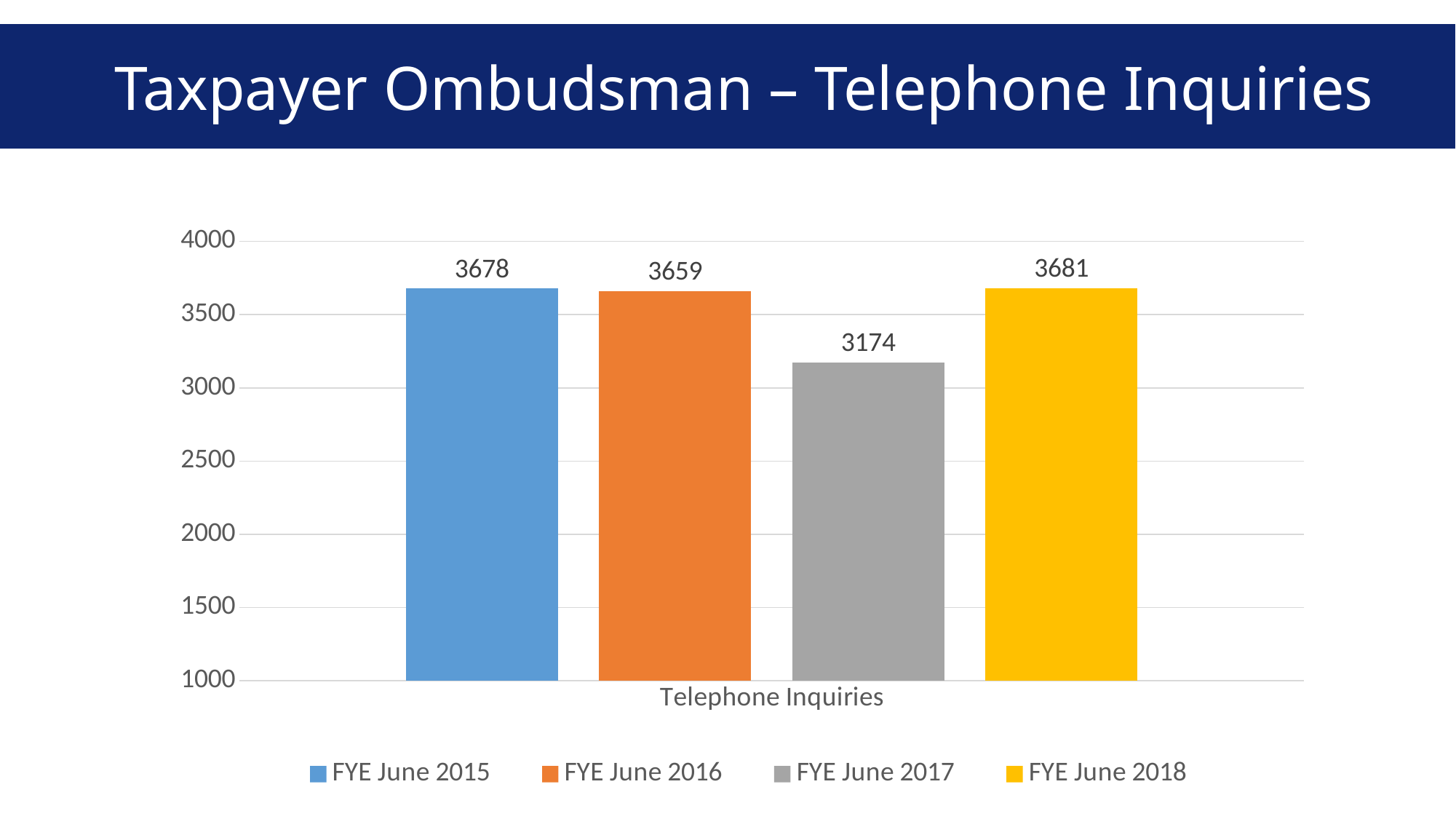
What is the difference between the values for FYE June 2018 and FYE June 2016? 22 What is the difference between the values for FYE June 2015 and FYE June 2017? 504 Which is larger, the value for FYE June 2016 or FYE June 2017? FYE June 2016 Which series has the lowest value? FYE June 2017 What is the value for FYE June 2017? 3174 What is the title of the slide? Taxpayer Ombudsman – Telephone Inquiries What is the value for FYE June 2015? 3678 What is the value for FYE June 2018? 3681 Is the value for FYE June 2017 greater or less than 3500? less What colour is the bar for FYE June 2018? yellow How many series does the legend list? 4 What kind of chart is shown on the slide? bar chart